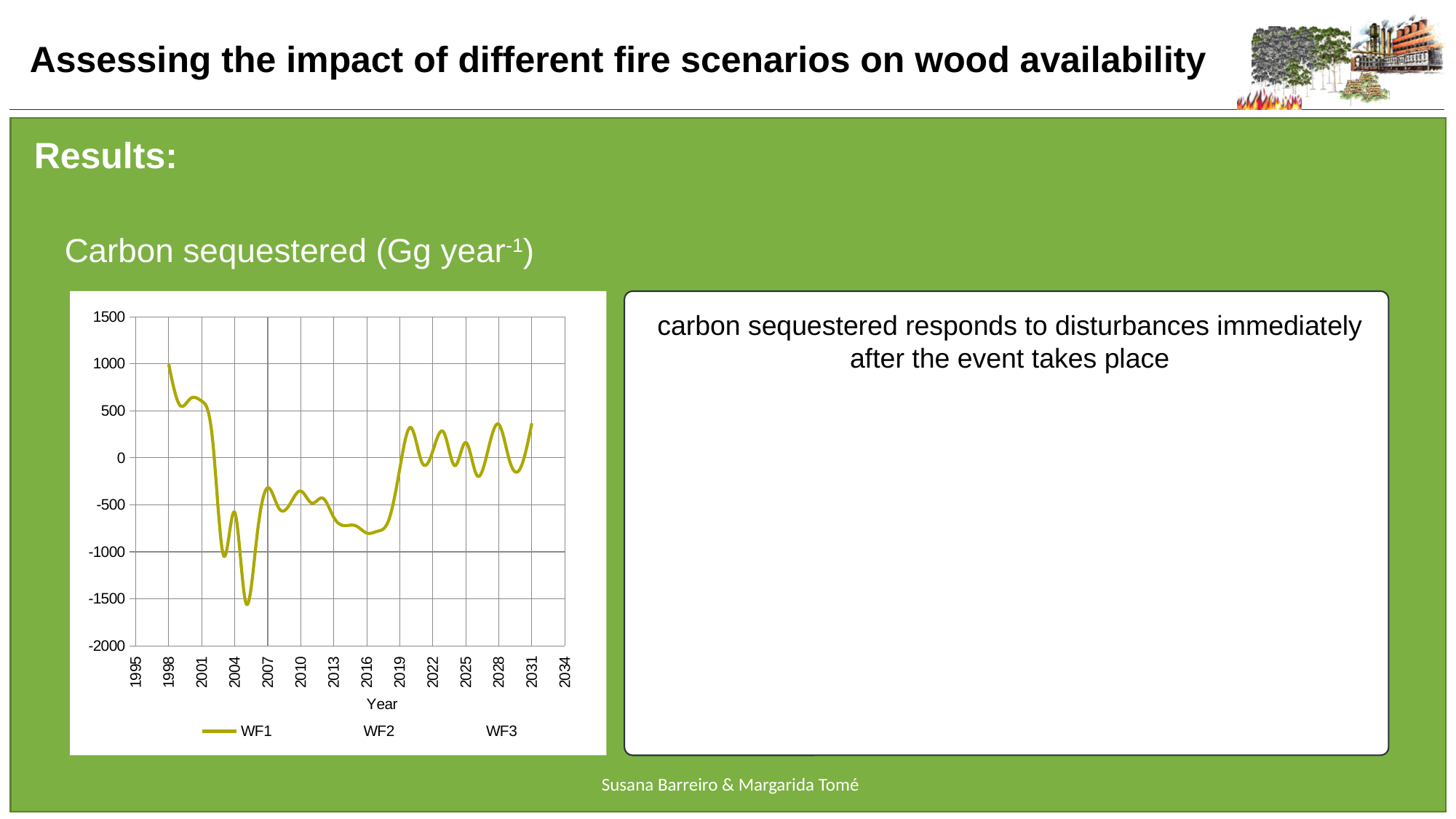
How many series does the chart legend list? 3 Does the WF1 line rise or fall between 2016 and 2020? rise Which series are listed in the chart legend? WF1, WF2, WF3 What kind of chart is shown on the slide? line chart What is the label of the x axis of the chart? Year Is the WF1 value in 2031 greater or less than 0? greater Which is larger, the WF1 value in 1998 or the WF1 value in 2031? 1998 Is the WF1 value in 2016 greater or less than -500? less Is the WF1 value in 1998 greater or less than 500? greater Does the WF1 line rise or fall between 1998 and 2006? fall